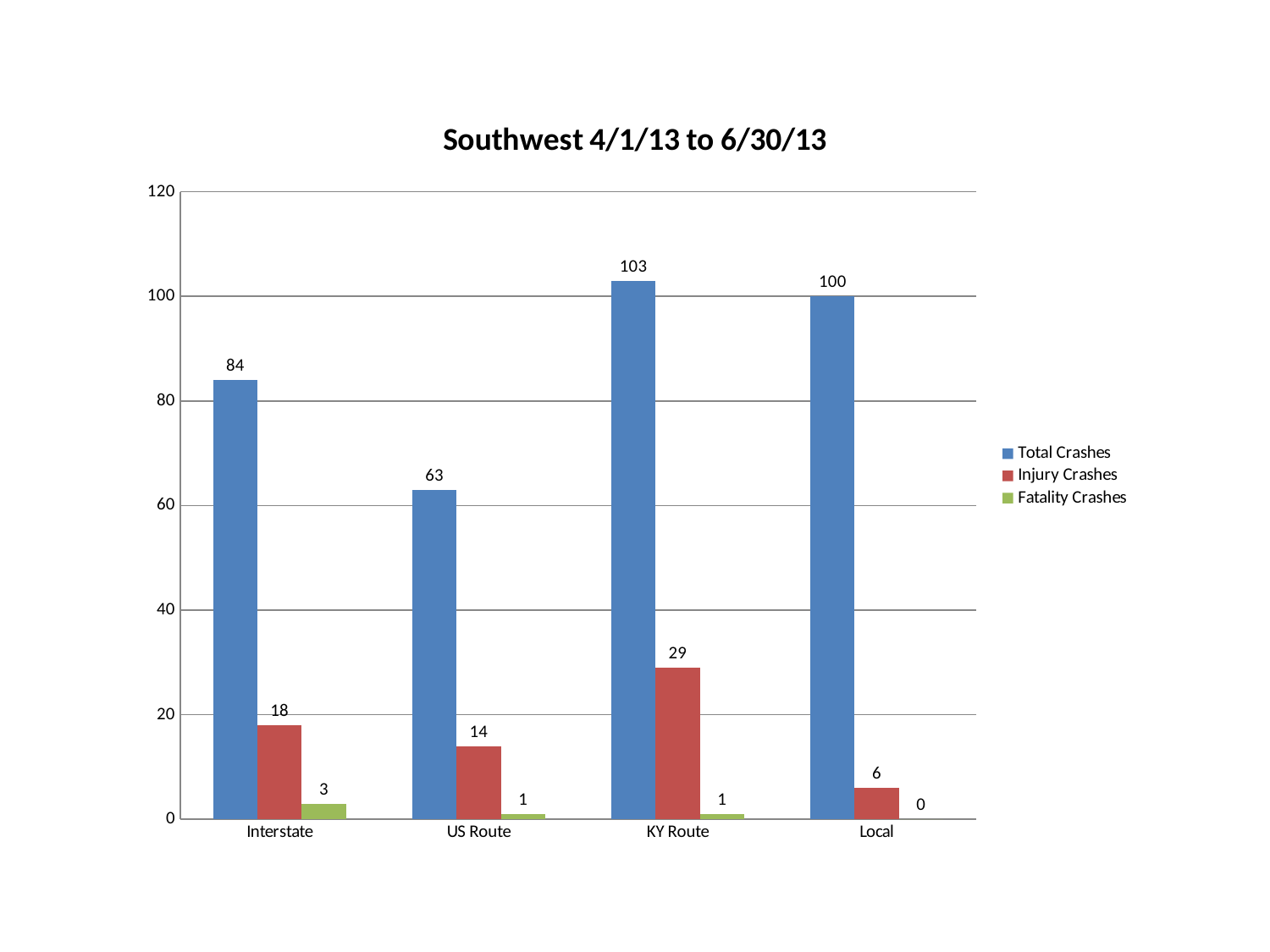
Which is larger, Injury Crashes for US Route or Injury Crashes for Interstate? Interstate What kind of chart is shown on the slide? Bar chart Is the value for Total Crashes for Interstate greater or less than 80? greater What is the title of the chart? Southwest 4/1/13 to 6/30/13 How many series does the legend list? 3 What is the number of Injury Crashes for Interstate? 18 Which category has the lowest number of Injury Crashes? Local Which category has the highest number of Total Crashes? KY Route What is the number of Total Crashes for KY Route? 103 How many categories are shown on the x axis? 4 What is the difference in Total Crashes between KY Route and US Route? 40 What is the number of Fatality Crashes for Local? 0